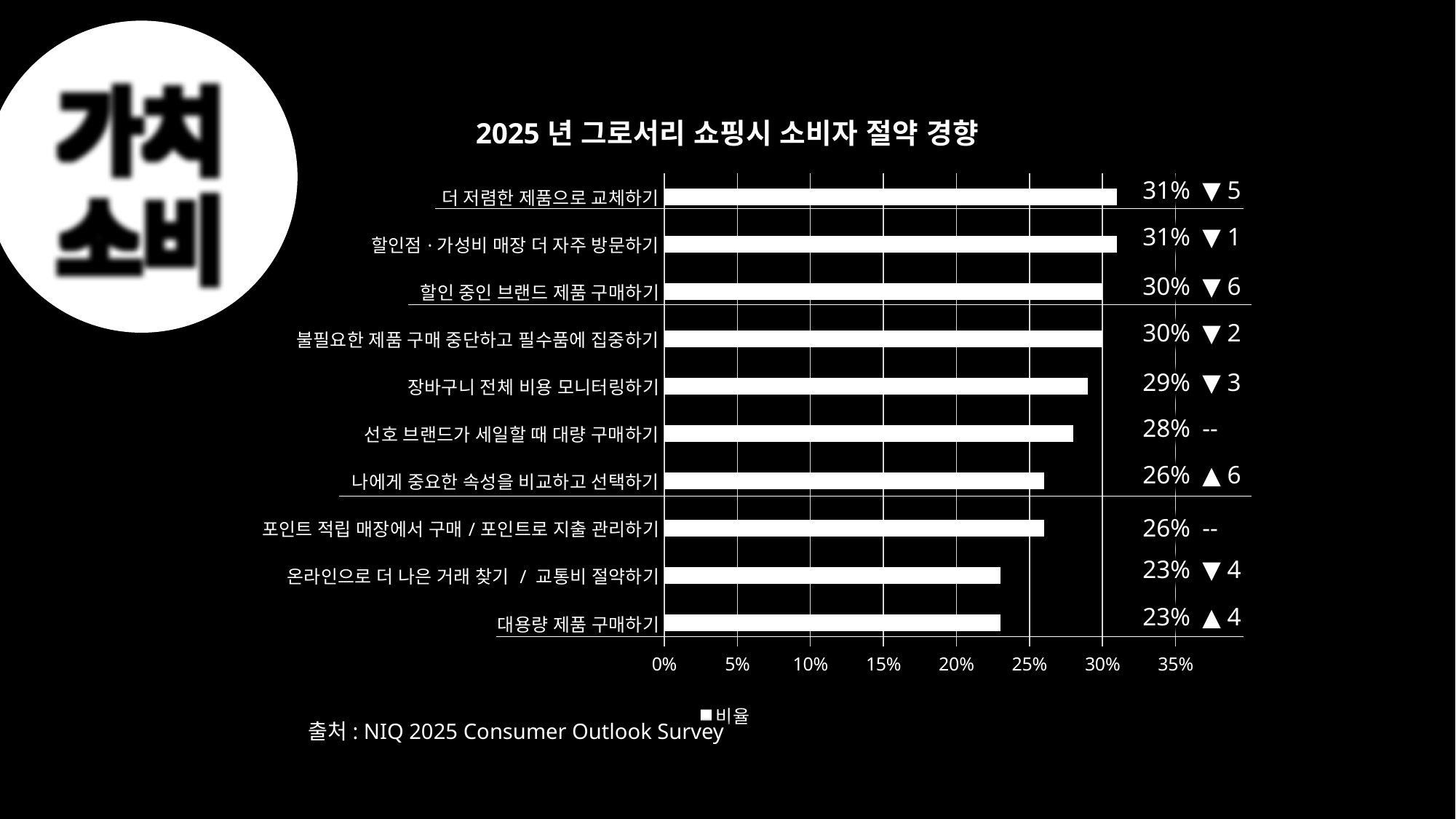
What is the value for 나에게 중요한 속성을 비교하고 선택하기? 26% What is the value for 선호 브랜드가 세일할 때 대량 구매하기? 28% Is the value for 포인트 적립 매장에서 구매 / 포인트로 지출 관리하기 greater or less than 30%? less What is the value for 더 저렴한 제품으로 교체하기? 31% How many series does the legend list? 1 What is the title of the chart? 2025 년 그로서리 쇼핑시 소비자 절약 경향 What kind of chart is shown on the slide? bar chart What is the value for 온라인으로 더 나은 거래 찾기 / 교통비 절약하기? 23% Which is larger, the value for 더 저렴한 제품으로 교체하기 or the value for 대용량 제품 구매하기? 더 저렴한 제품으로 교체하기 What is the difference between the values for 할인 중인 브랜드 제품 구매하기 and 대용량 제품 구매하기? 7% What is the value for 장바구니 전체 비용 모니터링하기? 29% How many categories are shown in the chart? 10